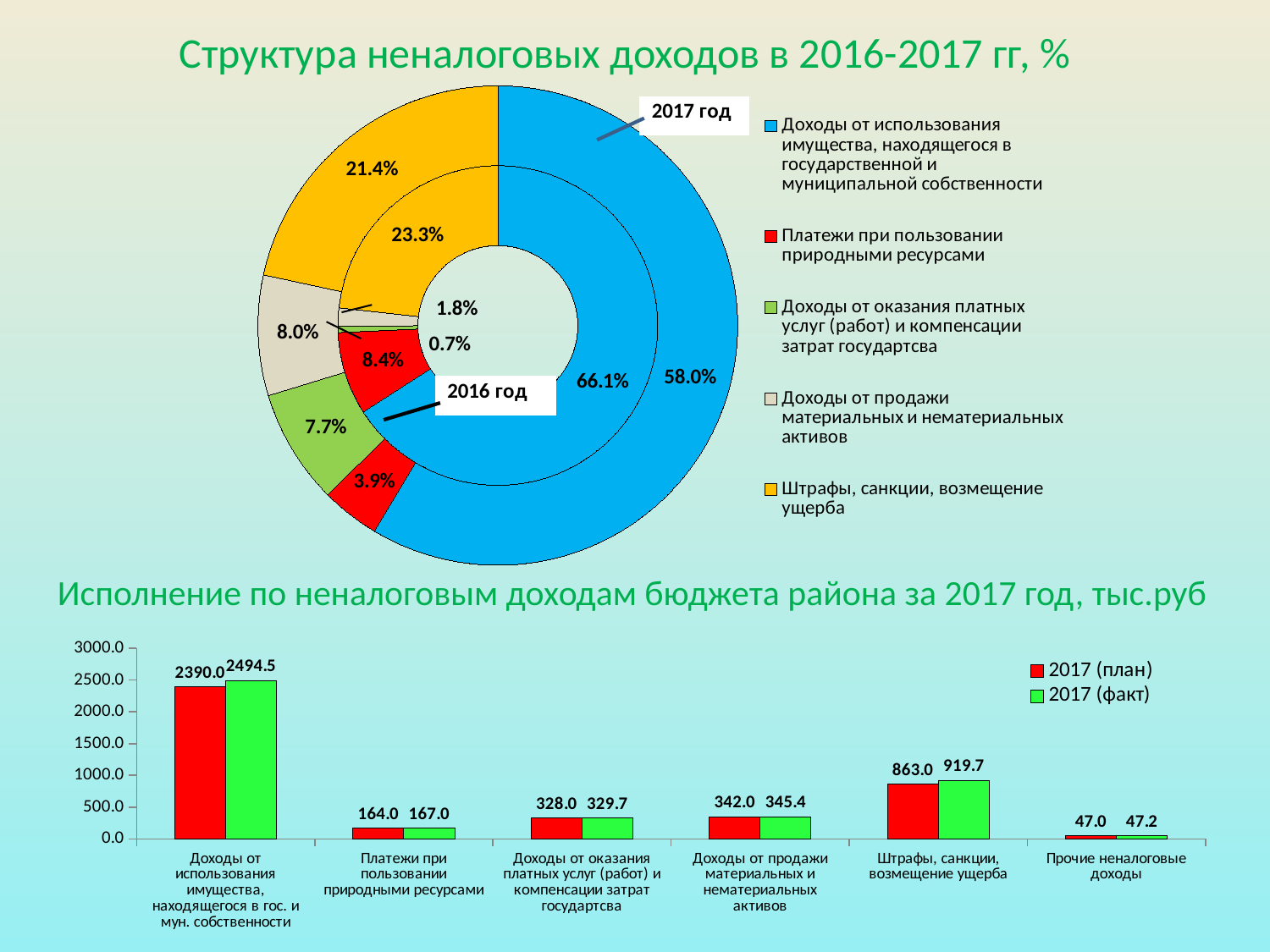
What type of chart is the top chart 'Структура неналоговых доходов в 2016-2017 гг, %'? Doughnut chart In the doughnut chart 'Структура неналоговых доходов в 2016-2017 гг, %', what share does 'Штрафы, санкции, возмещение ущерба' have in the 2017 ring? 21.4% In the doughnut chart 'Структура неналоговых доходов в 2016-2017 гг, %', which category has the largest share in the 2017 ring? Доходы от использования имущества, находящегося в государственной и муниципальной собственности In the doughnut chart 'Структура неналоговых доходов в 2016-2017 гг, %', which category has the smallest share in the 2016 ring? Доходы от оказания платных услуг (работ) и компенсации затрат государтсва In the bar chart 'Исполнение по неналоговым доходам бюджета района за 2017 год, тыс.руб', how many series does the legend list? 2 In the doughnut chart 'Структура неналоговых доходов в 2016-2017 гг, %', how many categories does the legend list? 5 In the bar chart 'Исполнение по неналоговым доходам бюджета района за 2017 год, тыс.руб', what is the 2017 (план) value for 'Платежи при пользовании природными ресурсами'? 164.0 In the doughnut chart 'Структура неналоговых доходов в 2016-2017 гг, %', by how many percentage points did the share of 'Доходы от использования имущества' change from 2016 (66.1%) to 2017 (58.0%)? 8.1 In the bar chart 'Исполнение по неналоговым доходам бюджета района за 2017 год, тыс.руб', what is the 2017 (факт) value for 'Штрафы, санкции, возмещение ущерба'? 919.7 In the bar chart 'Исполнение по неналоговым доходам бюджета района за 2017 год, тыс.руб', what is the difference between the 2017 (факт) and 2017 (план) values for 'Доходы от использования имущества, находящегося в гос. и мун. собственности'? 104.5 In the doughnut chart 'Структура неналоговых доходов в 2016-2017 гг, %', what share does 'Платежи при пользовании природными ресурсами' have in the 2016 ring? 8.4% In the bar chart 'Исполнение по неналоговым доходам бюджета района за 2017 год, тыс.руб', which category has the lowest values? Прочие неналоговые доходы